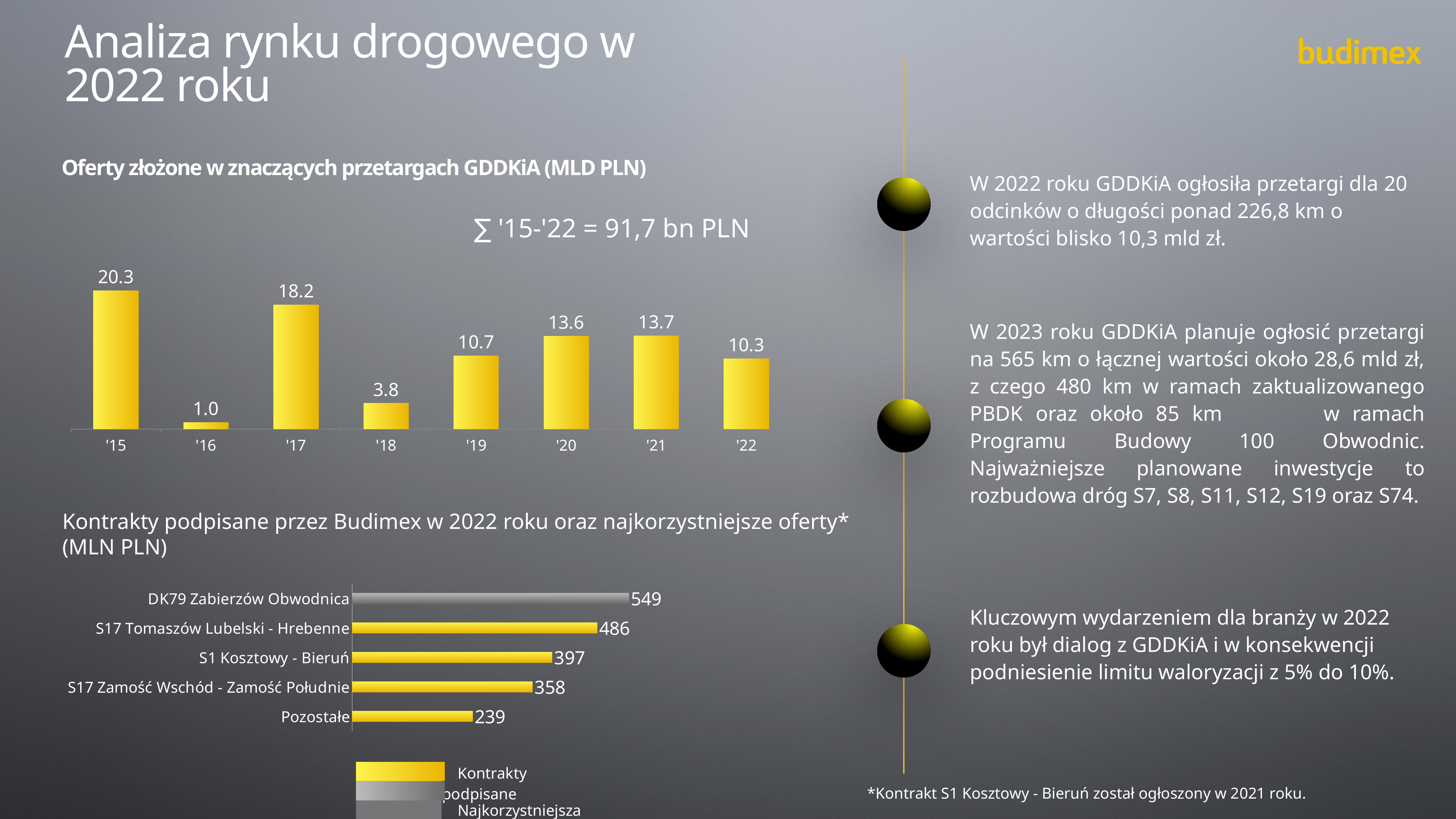
In the chart 'Oferty złożone w znaczących przetargach GDDKiA (MLD PLN)', what total for '15-'22 is printed on the chart? 91,7 bn PLN In the chart 'Kontrakty podpisane przez Budimex w 2022 roku oraz najkorzystniejsze oferty* (MLN PLN)', which is larger: S17 Tomaszów Lubelski - Hrebenne or S17 Zamość Wschód - Zamość Południe? S17 Tomaszów Lubelski - Hrebenne What kind of chart is 'Oferty złożone w znaczących przetargach GDDKiA (MLD PLN)'? bar chart In the chart 'Oferty złożone w znaczących przetargach GDDKiA (MLD PLN)', what is the difference between the values for '21 and '22? 3.4 In the chart 'Kontrakty podpisane przez Budimex w 2022 roku oraz najkorzystniejsze oferty* (MLN PLN)', how many categories are listed? 5 In the chart 'Oferty złożone w znaczących przetargach GDDKiA (MLD PLN)', which year has the highest value? '15 In the chart 'Kontrakty podpisane przez Budimex w 2022 roku oraz najkorzystniejsze oferty* (MLN PLN)', what is the value for S1 Kosztowy - Bieruń? 397 In the chart 'Oferty złożone w znaczących przetargach GDDKiA (MLD PLN)', how many years are shown on the x axis? 8 In the chart 'Kontrakty podpisane przez Budimex w 2022 roku oraz najkorzystniejsze oferty* (MLN PLN)', what is the difference between DK79 Zabierzów Obwodnica and Pozostałe? 310 In the chart 'Kontrakty podpisane przez Budimex w 2022 roku oraz najkorzystniejsze oferty* (MLN PLN)', which category has the highest value? DK79 Zabierzów Obwodnica In the chart 'Oferty złożone w znaczących przetargach GDDKiA (MLD PLN)', what is the value for '17? 18.2 In the chart 'Oferty złożone w znaczących przetargach GDDKiA (MLD PLN)', which year has the lowest value? '16